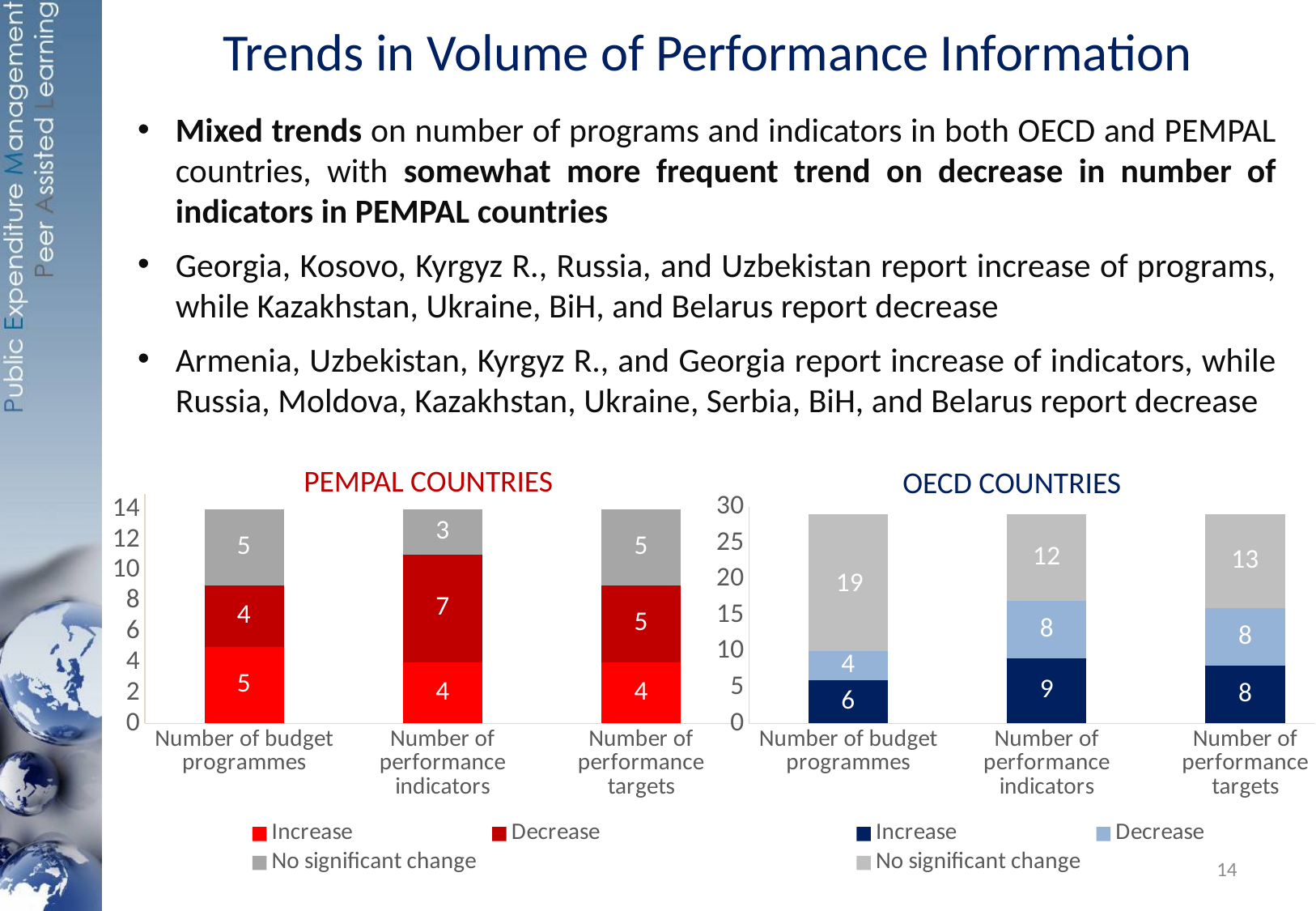
In the PEMPAL COUNTRIES chart, what is the value for Decrease for Number of performance indicators? 7 How many series does the legend of the OECD COUNTRIES chart list? 3 In the PEMPAL COUNTRIES chart, what is the total of the stacked bar for Number of performance targets? 14 In the PEMPAL COUNTRIES chart, is the Increase value for Number of budget programmes larger or smaller than the Increase value for Number of performance targets? larger In the PEMPAL COUNTRIES chart, which category has the highest Decrease value? Number of performance indicators In the OECD COUNTRIES chart, what is the value for No significant change for Number of budget programmes? 19 In the OECD COUNTRIES chart, which category has the lowest Decrease value? Number of budget programmes How many categories are shown on the x axis of the PEMPAL COUNTRIES chart? 3 In the OECD COUNTRIES chart, what is the value for Increase for Number of performance indicators? 9 What kind of chart is the PEMPAL COUNTRIES chart? Stacked bar chart In the OECD COUNTRIES chart, what is the difference between the No significant change values for Number of budget programmes and Number of performance indicators? 7 In the OECD COUNTRIES chart, what is the total of the stacked bar for Number of performance indicators? 29